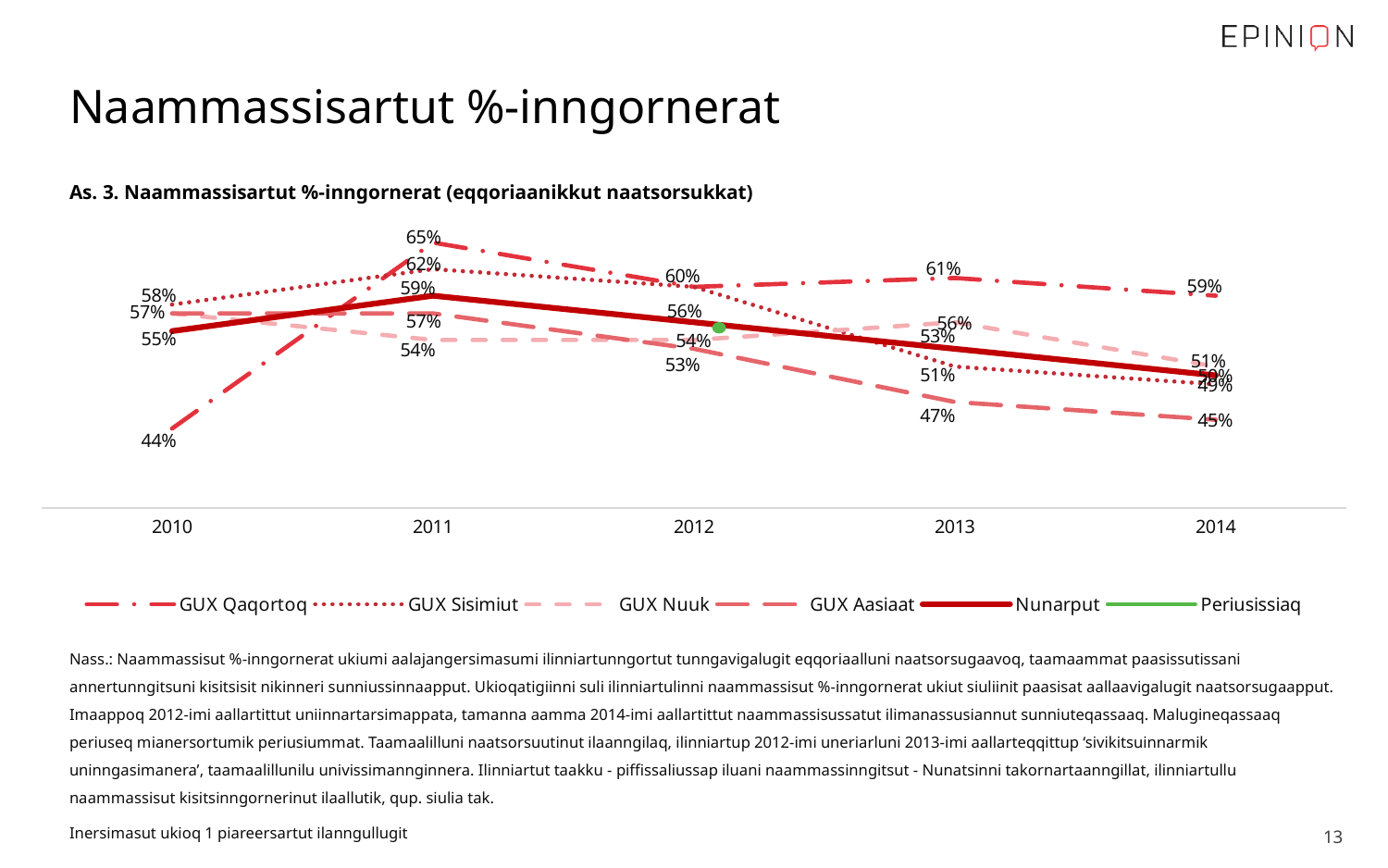
How many years are shown on the x axis? 5 What is the value for GUX Qaqortoq in 2010? 44% Does the Nunarput line rise or fall from 2011 to 2014? Falls What kind of chart is shown on the slide? Line chart Which series has the lowest value in 2014? GUX Aasiaat What is the title of the chart? As. 3. Naammassisartut %-inngornerat (eqqoriaanikkut naatsorsukkat) Which series has the highest value in 2011? GUX Qaqortoq How many series does the legend list? 6 What is the value for Nunarput in 2014? 50% By how many percentage points did GUX Qaqortoq change from 2010 to 2011? 21 percentage points What is the value for GUX Qaqortoq in 2011? 65% What is the value for GUX Aasiaat in 2014? 45%